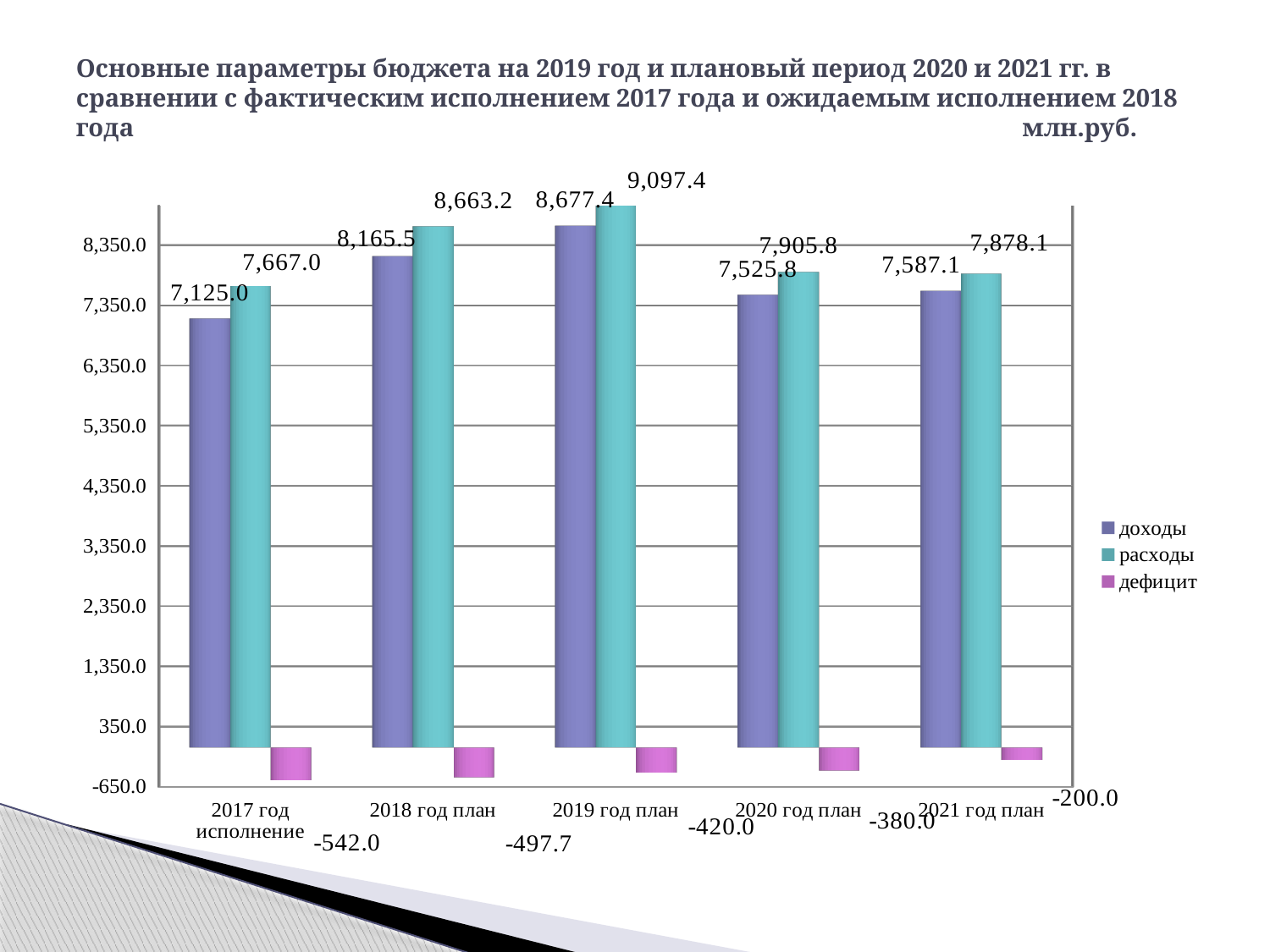
What is the value of дефицит for 2020 год план? -380.0 Which category has the lowest value for доходы? 2017 год исполнение How many categories are shown on the x axis? 5 Which is larger, доходы for 2020 год план or доходы for 2021 год план? 2021 год план What unit of measurement is stated for the chart? млн.руб. What is the value of расходы for 2017 год исполнение? 7,667.0 What is the value of доходы for 2019 год план? 8,677.4 What kind of chart is shown on the slide? bar chart Is the value of доходы for 2017 год исполнение greater or less than 7,350.0? less How many series does the legend list? 3 What is the difference between расходы and доходы for 2018 год план? 497.7 Which category has the highest value for расходы? 2019 год план